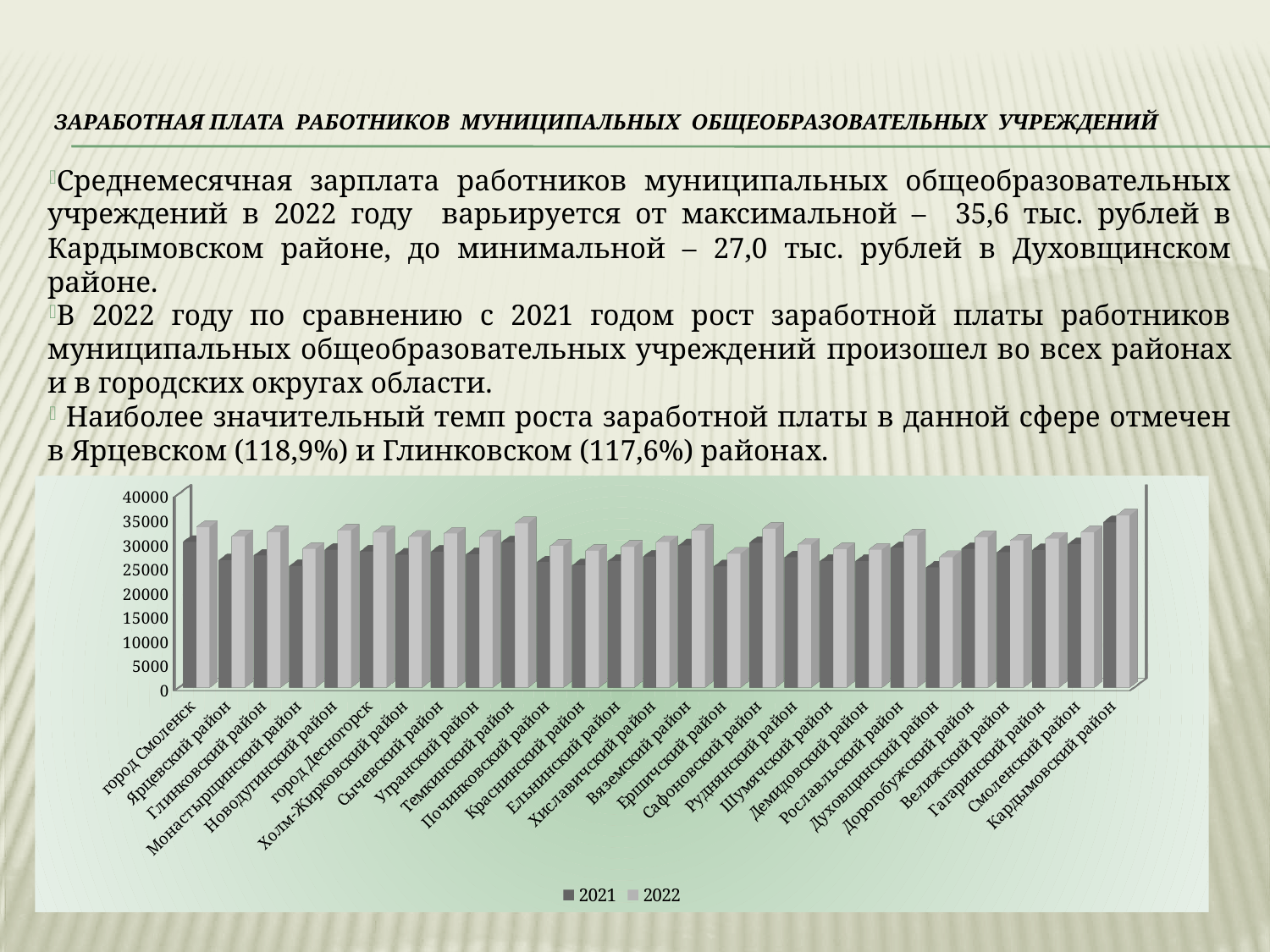
Which category has the lowest value for 2022 in the chart? Духовщинский район Which category has the highest value for 2022 in the chart? Кардымовский район For Кардымовский район, which is larger: the 2021 value or the 2022 value? 2022 For Глинковский район, which is larger: the 2021 value or the 2022 value? 2022 Which years are listed in the chart legend? 2021 and 2022 What kind of chart is shown on the slide? bar chart Which series is drawn in the darker grey bars in the chart? 2021 How many series does the chart legend list? 2 Is the 2022 value for Духовщинский район greater or less than 30000? less How many districts and cities are shown along the x axis of the chart? 27 Is the 2021 value for Кардымовский район greater or less than 30000? greater